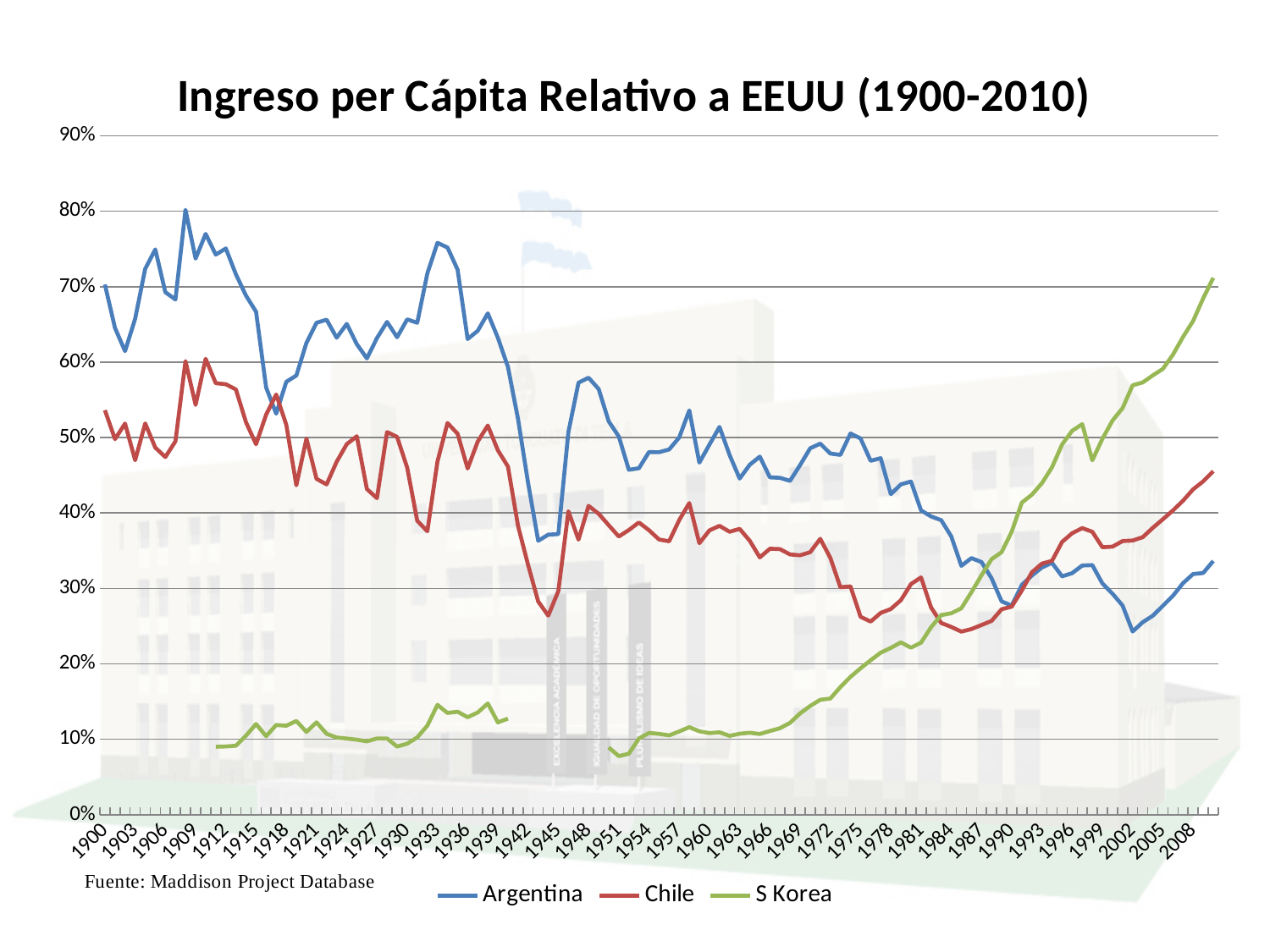
What is the title of the chart? Ingreso per Cápita Relativo a EEUU (1900-2010) Which series has the highest value at the end of the period (2010)? S Korea What kind of chart is shown on the slide? line chart How many series does the legend list? 3 Is the value for S Korea in 1930 greater or less than 20%? less Is the value for S Korea at the end of the period (2010) greater or less than 60%? greater In 2008, which series has the higher value, Chile or Argentina? Chile Does the S Korea line rise or fall from 1960 to 2010? rise In 1960, which series has the higher value, Argentina or Chile? Argentina Which series has the lowest value in 1960? S Korea Is the value for Argentina in 1909 greater or less than 70%? greater What source is cited below the chart? Maddison Project Database